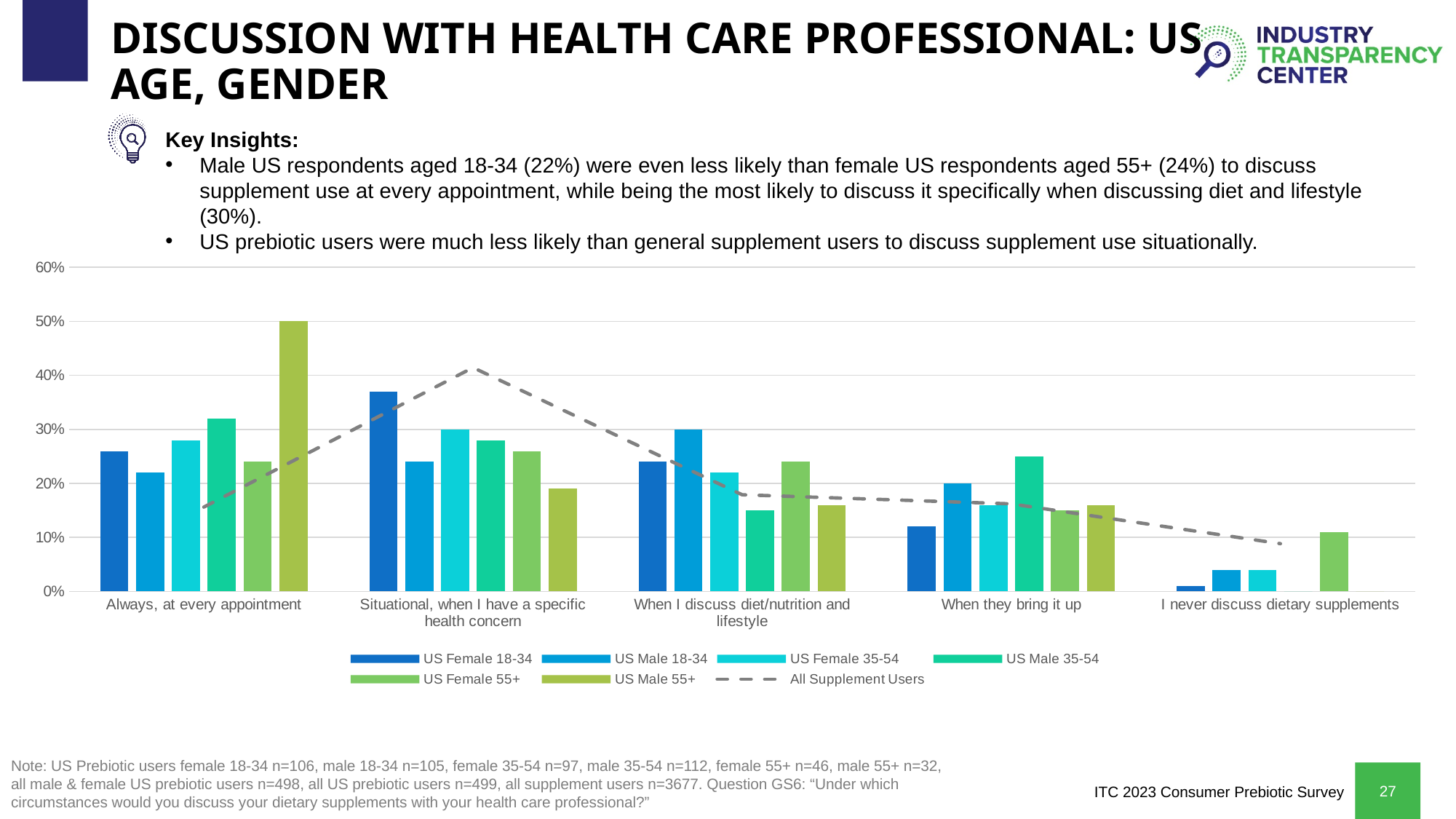
What is the value for US Male 18-34 in the 'When I discuss diet/nutrition and lifestyle' category? 30% What is the value for US Male 55+ in the 'Always, at every appointment' category? 50% How many series does the chart legend list? 7 What is the value for US Male 18-34 in the 'When they bring it up' category? 20% Which series in the legend is drawn as a dashed line rather than bars? All Supplement Users Which series has the highest value in the 'When they bring it up' category? US Male 35-54 How many categories are shown along the x axis of the chart? 5 What type of chart is shown on the slide? bar and line chart Which series has the highest value in the 'Situational, when I have a specific health concern' category? All Supplement Users Which series has the highest value in the 'Always, at every appointment' category? US Male 55+ Is the value for US Female 18-34 in the 'Situational, when I have a specific health concern' category greater or less than 30%? greater Is the value for US Female 18-34 in the 'I never discuss dietary supplements' category greater or less than 10%? less